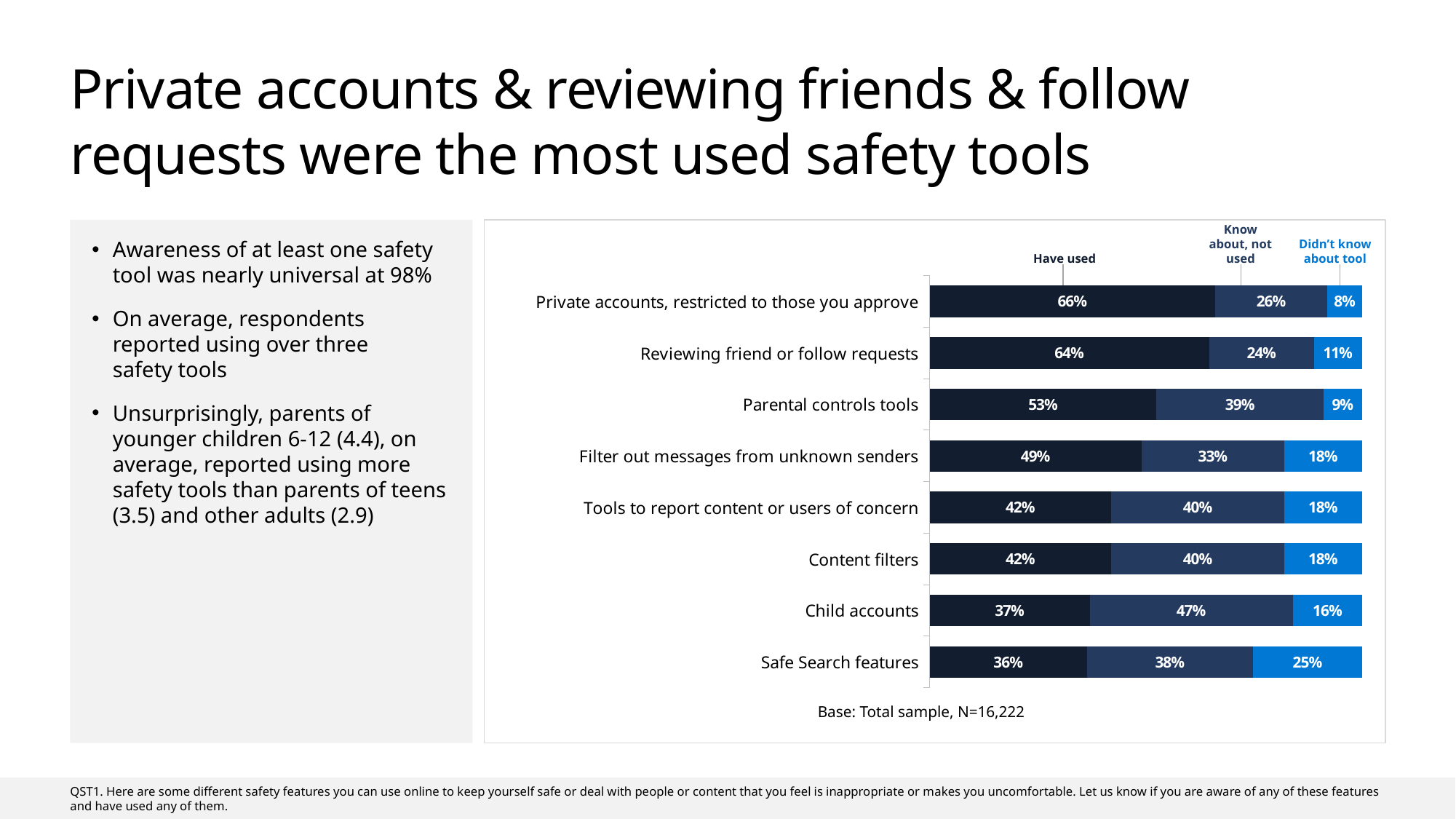
How many series does the chart show? 3 Which safety tool has the lowest 'Didn't know about tool' percentage? Private accounts, restricted to those you approve What is the difference in 'Have used' percentage between Private accounts, restricted to those you approve and Reviewing friend or follow requests? 2 percentage points What is the 'Know about, not used' value for Child accounts? 47% Which safety tool has the lowest 'Have used' percentage? Safe Search features Which has a higher 'Have used' percentage: Parental controls tools or Filter out messages from unknown senders? Parental controls tools What is the 'Didn't know about tool' value for Safe Search features? 25% What is the base sample size stated below the chart? N=16,222 Which safety tool has the highest 'Have used' percentage? Private accounts, restricted to those you approve What percentage of respondents have used Parental controls tools? 53% How many safety tools (categories) are listed in the chart? 8 What kind of chart is shown on the slide? Stacked bar chart